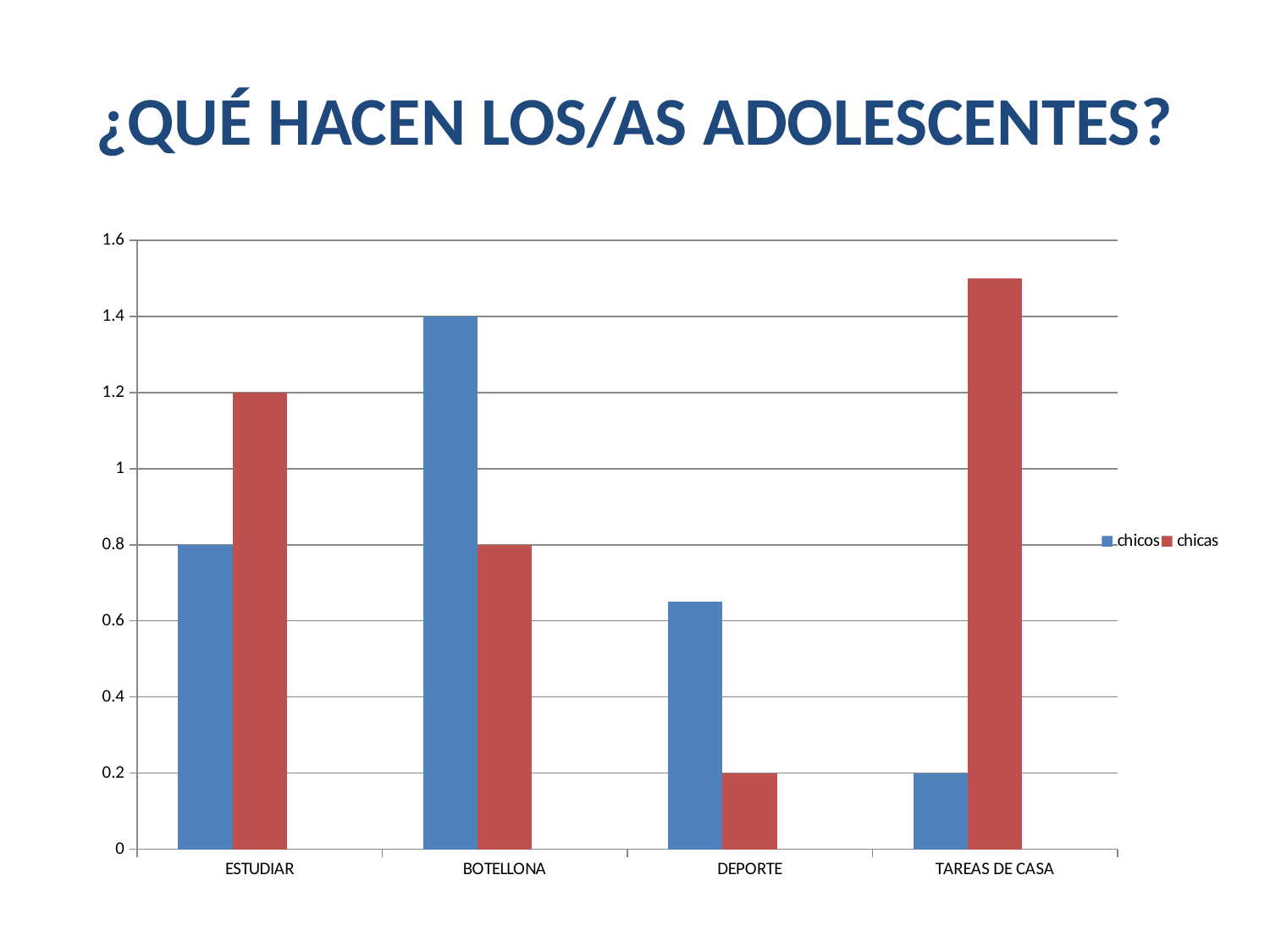
What is the value for chicas in the ESTUDIAR category? 1.2 What type of chart is shown on the slide? bar chart In the TAREAS DE CASA category, which series has the larger value, chicos or chicas? chicas Which category has the lowest value for chicas? DEPORTE Is the value for chicos in the DEPORTE category greater or less than 0.6? greater Which category has the highest value for chicos? BOTELLONA What is the difference between the chicas and chicos values in the ESTUDIAR category? 0.4 What is the value for chicas in the DEPORTE category? 0.2 What is the value for chicos in the BOTELLONA category? 1.4 What is the value for chicos in the ESTUDIAR category? 0.8 Is the value for chicas in the TAREAS DE CASA category greater or less than 1.4? greater How many categories are shown on the x axis? 4